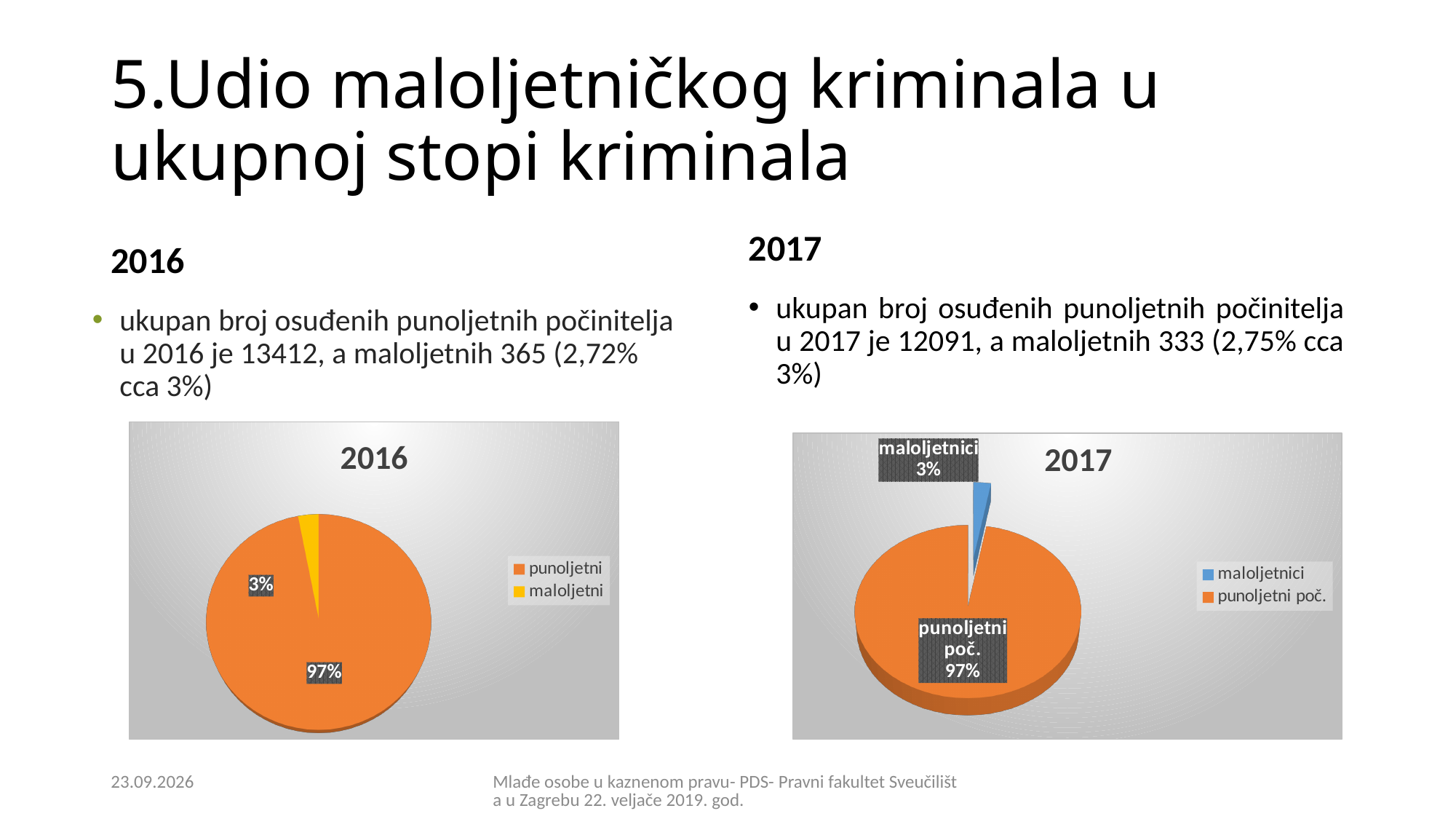
In the chart titled "2017", what share of the pie is labelled for maloljetnici? 3% How many categories does the legend of the chart titled "2017" list? 2 In the chart titled "2017", which category has the smallest slice? maloljetnici In the chart titled "2016", which slice is larger, punoljetni or maloljetni? punoljetni In the chart titled "2017", what share of the pie is labelled for punoljetni poč.? 97% In the chart titled "2016", what colour is the maloljetni slice? yellow In the chart titled "2016", which category has the largest slice? punoljetni In the chart titled "2017", what colour is the maloljetnici slice? blue In the chart titled "2016", what share of the pie is labelled for maloljetni? 3% In the chart titled "2017", what is the difference in percentage points between the punoljetni poč. slice and the maloljetnici slice? 94 percentage points What kind of chart is the chart titled "2016"? pie chart